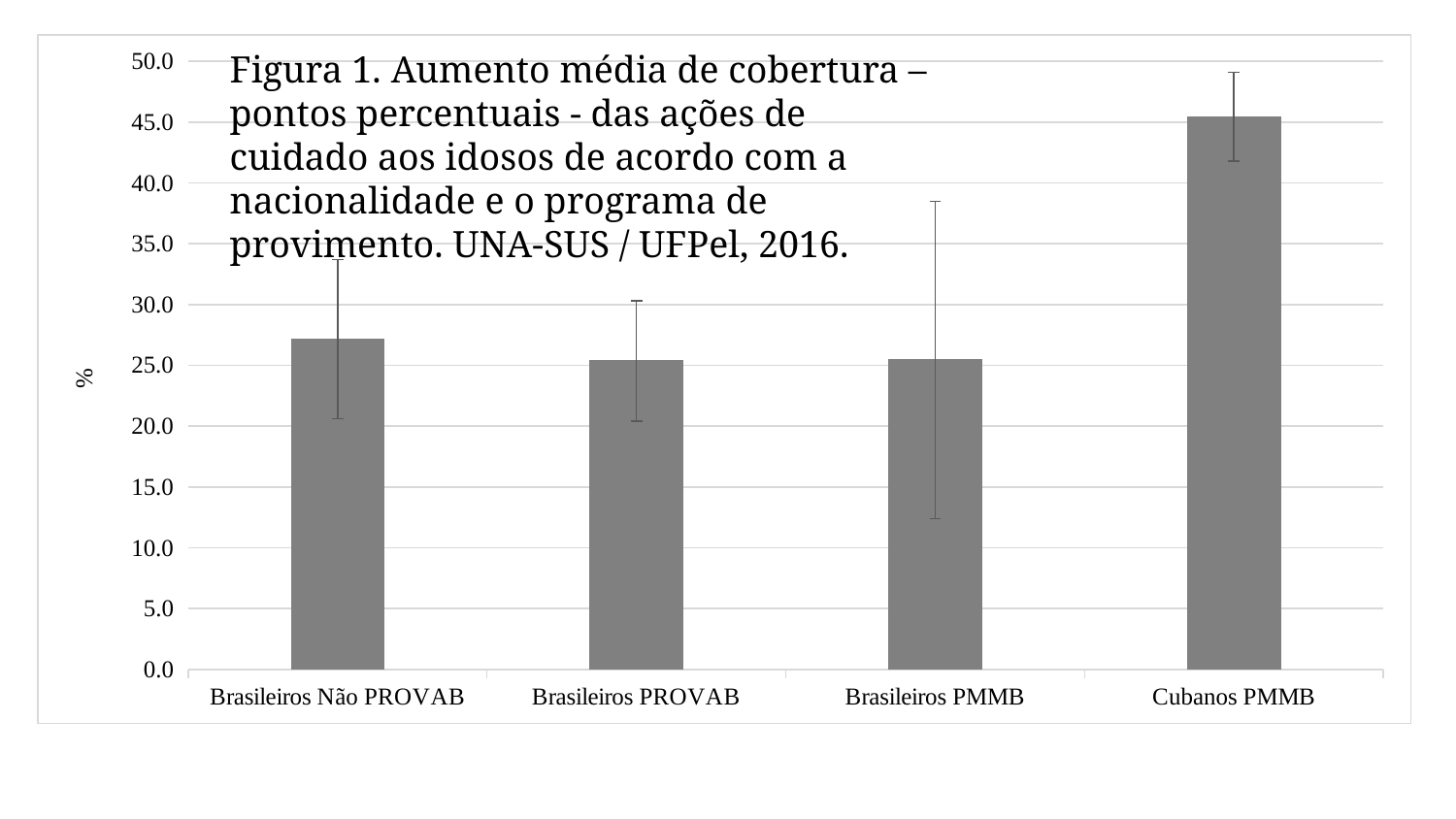
Is the value for Brasileiros PMMB greater or less than 30.0? less Is the value for Brasileiros PROVAB greater or less than 20.0? greater Which is larger, the value for Cubanos PMMB or the value for Brasileiros PMMB? Cubanos PMMB Which is larger, the value for Brasileiros PROVAB or the value for Cubanos PMMB? Cubanos PMMB Is the value for Brasileiros Não PROVAB greater or less than 30.0? less What is the label on the vertical axis of the chart? % What is the maximum value shown on the vertical axis of the chart? 50.0 Which category has the highest value in the chart? Cubanos PMMB What kind of chart is shown on the slide? bar chart How many categories are shown on the x axis of the chart? 4